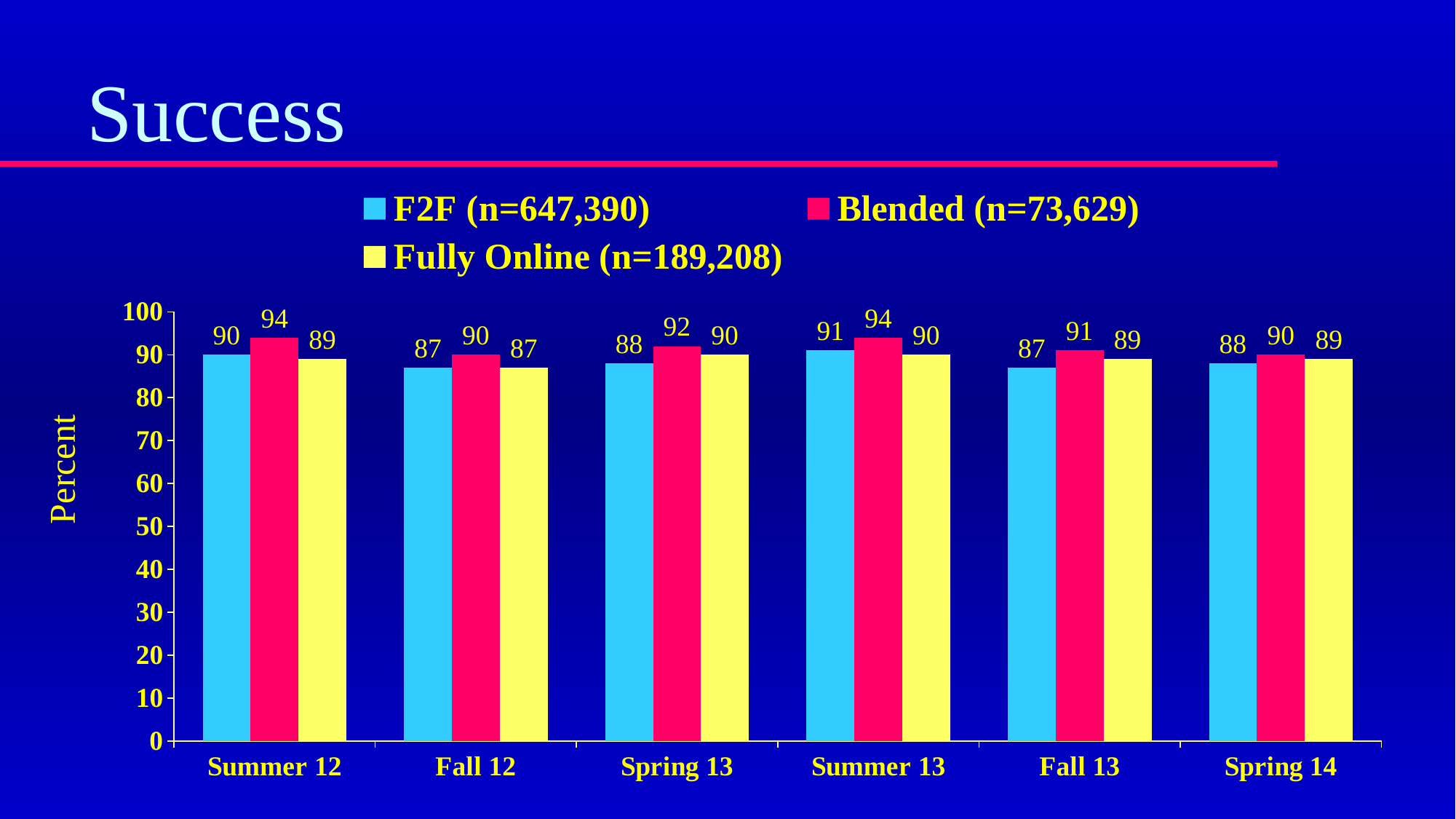
In which term does the Blended series reach its lowest value? Fall 12 and Spring 14 (both 90) Which is larger in Fall 13: the F2F value or the Fully Online value? Fully Online How many terms are shown on the x axis? 6 How many series does the legend list? 3 What kind of chart is shown on the slide? Bar chart What is the F2F success percentage for Summer 12? 90 What is the label of the y axis? Percent What is the Blended success percentage for Spring 13? 92 What sample size (n) is given for the Blended series in the legend? 73,629 What is the difference between the Blended and Fully Online values in Summer 13? 4 What is the difference between the Blended and F2F values in Summer 12? 4 What is the Fully Online success percentage for Fall 12? 87